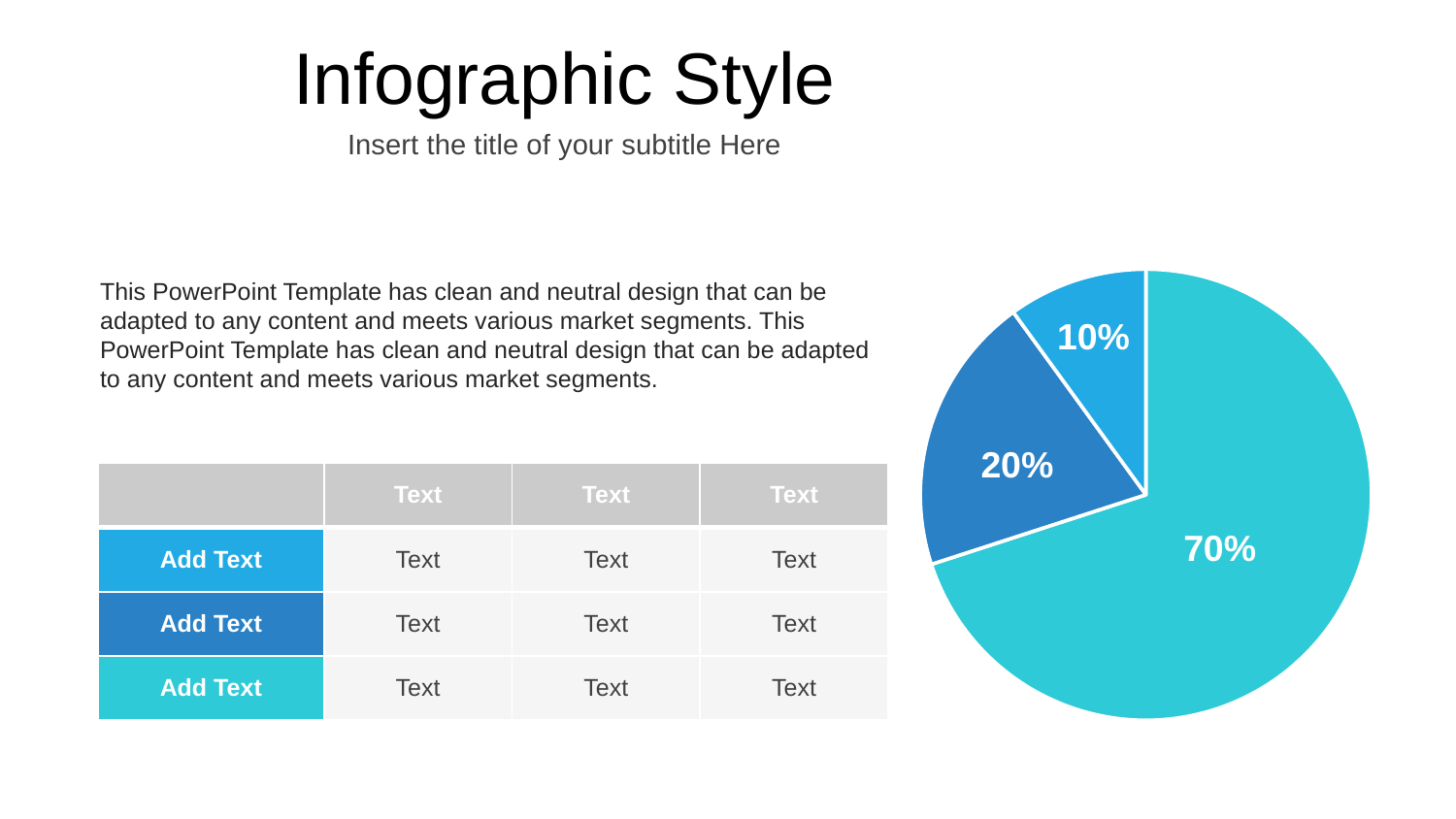
What kind of chart is shown on the right of the slide? pie chart Which is larger in the pie chart, the dark blue slice or the light blue slice? the dark blue slice What percentage is shown on the largest slice of the pie chart? 70% What share of the pie does the teal slice represent? 70% What value is labelled on the dark blue slice of the pie chart? 20% What value is labelled on the light blue slice at the top of the pie chart? 10% How many slices does the pie chart have? 3 What is the difference between the largest and smallest slices of the pie chart? 60% What is the difference between the 20% slice and the 10% slice of the pie chart? 10% What percentage is shown on the smallest slice of the pie chart? 10% What value is labelled on the teal (light turquoise) slice of the pie chart? 70% What colour is the 20% slice of the pie chart? dark blue